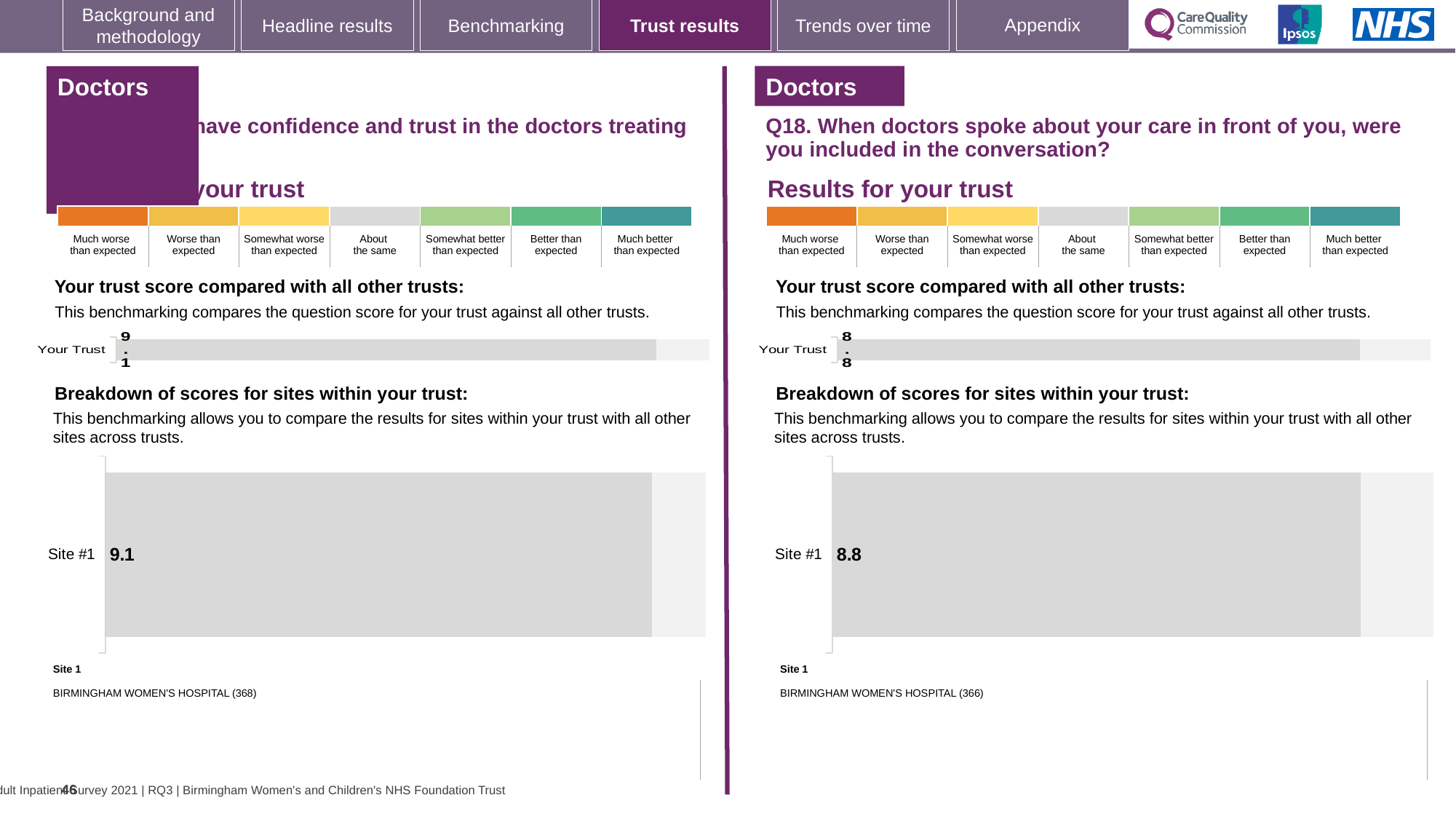
Which is larger: the Site #1 score on the left-hand side of the slide or the Site #1 score on the right-hand side (Q18)? Left-hand side (9.1) What is the name of the site labelled Site 1 on the right-hand side of the slide (Q18)? BIRMINGHAM WOMEN'S HOSPITAL (366) On the right-hand side of the slide (Q18), what score is shown for 'Your Trust' in the trust score comparison chart? 8.8 How many sites are shown in the breakdown of scores chart on the left-hand side of the slide? 1 On the left-hand side of the slide, what score is shown for 'Your Trust' in the trust score comparison chart? 9.1 What is the difference between the Site #1 score on the left-hand side of the slide (9.1) and the Site #1 score on the right-hand side (8.8)? 0.3 What kind of chart is used to show the Site #1 score on the right-hand side of the slide (Q18)? Bar chart What is the name of the site labelled Site 1 on the left-hand side of the slide? BIRMINGHAM WOMEN'S HOSPITAL (368) On the right-hand side of the slide (Q18), what is the score shown for Site #1 in the breakdown of scores for sites within your trust? 8.8 On the left-hand side of the slide, what is the score shown for Site #1 in the breakdown of scores for sites within your trust? 9.1 How many sites are shown in the breakdown of scores chart on the right-hand side of the slide (Q18)? 1